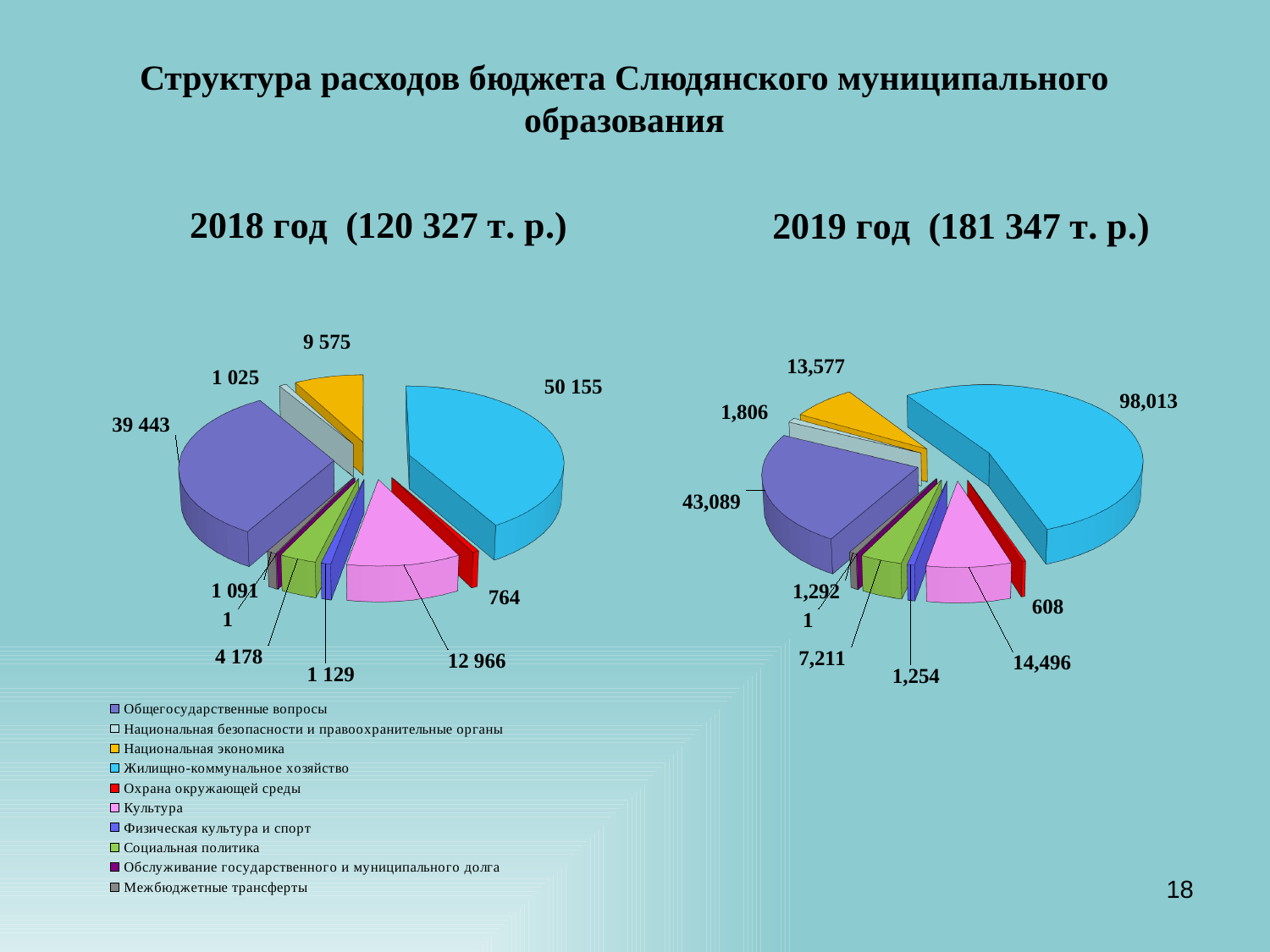
What total is given in the heading for the 2019 chart? 181 347 т. р. On the 2018 pie chart, what is the difference between Жилищно-коммунальное хозяйство and Общегосударственные вопросы? 10 712 On the 2019 pie chart, what is the difference between Жилищно-коммунальное хозяйство and Общегосударственные вопросы? 54,924 On the 2019 pie chart, which is larger: Социальная политика or Национальная экономика? Национальная экономика On the 2019 pie chart, which category has the largest slice? Жилищно-коммунальное хозяйство What kind of charts are shown on the slide? Pie charts On the 2018 pie chart, which category has the smallest value? Обслуживание государственного и муниципального долга On the 2019 pie chart, what is the value for Общегосударственные вопросы? 43,089 On the 2018 pie chart, what is the value for Жилищно-коммунальное хозяйство? 50 155 How many categories does the legend list? 10 On the 2018 pie chart, what is the value for Национальная экономика? 9 575 On the 2019 pie chart, what is the value for Культура? 14,496